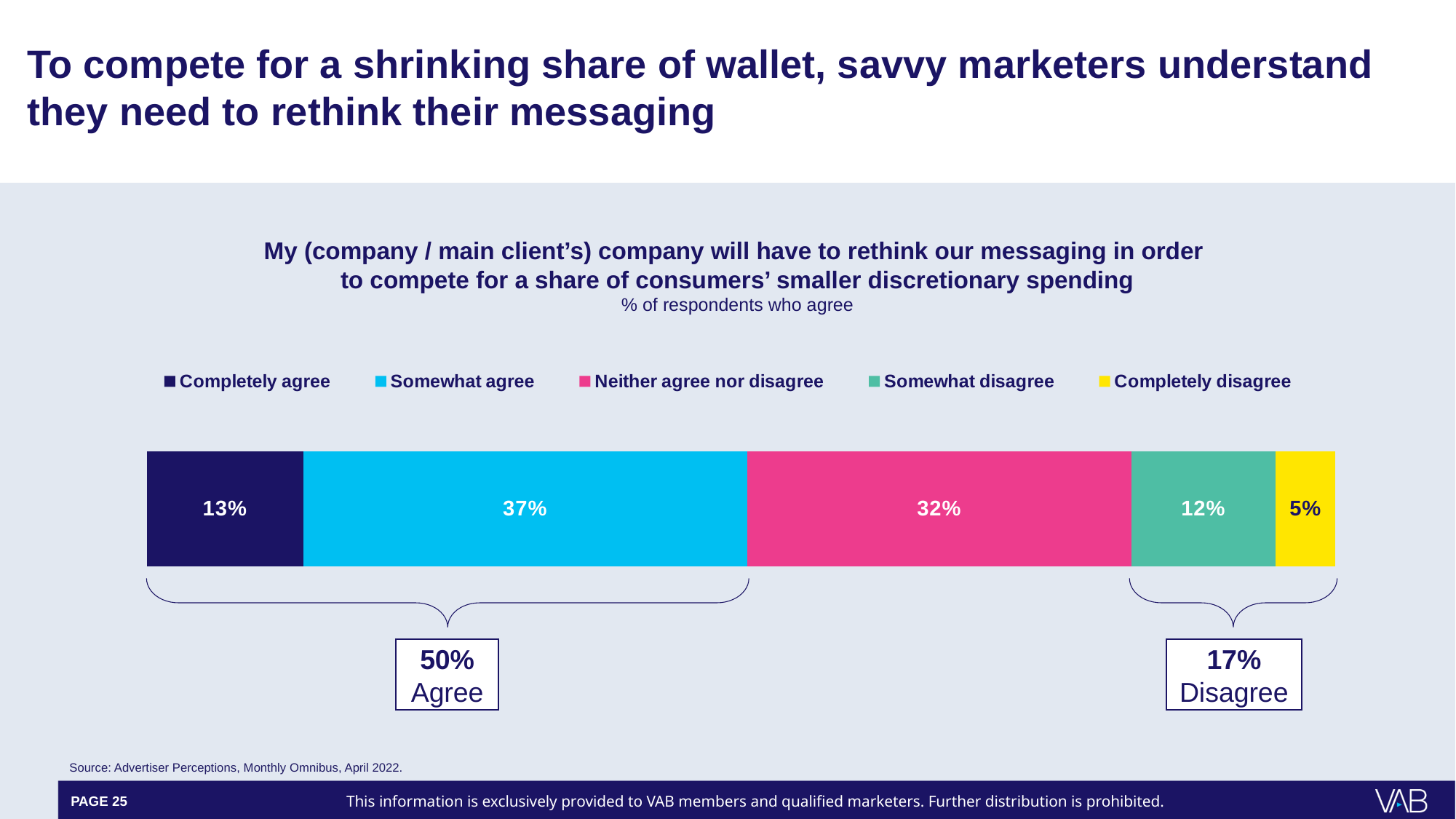
How many response categories does the legend list? 5 Which is larger, the share who completely agree or the share who somewhat disagree? Completely agree Which response category has the largest share of respondents? Somewhat agree What percentage of respondents completely disagree? 5% Which response category has the smallest share of respondents? Completely disagree What percentage of respondents neither agree nor disagree? 32% What type of chart is used to show the responses? Stacked bar chart What percentage of respondents somewhat agree? 37% What percentage of respondents completely agree that their company will have to rethink its messaging? 13% What is the difference in percentage points between 'Somewhat agree' and 'Neither agree nor disagree'? 5 What percentage of respondents somewhat disagree? 12% What is the combined percentage of respondents who agree (completely or somewhat)? 50%